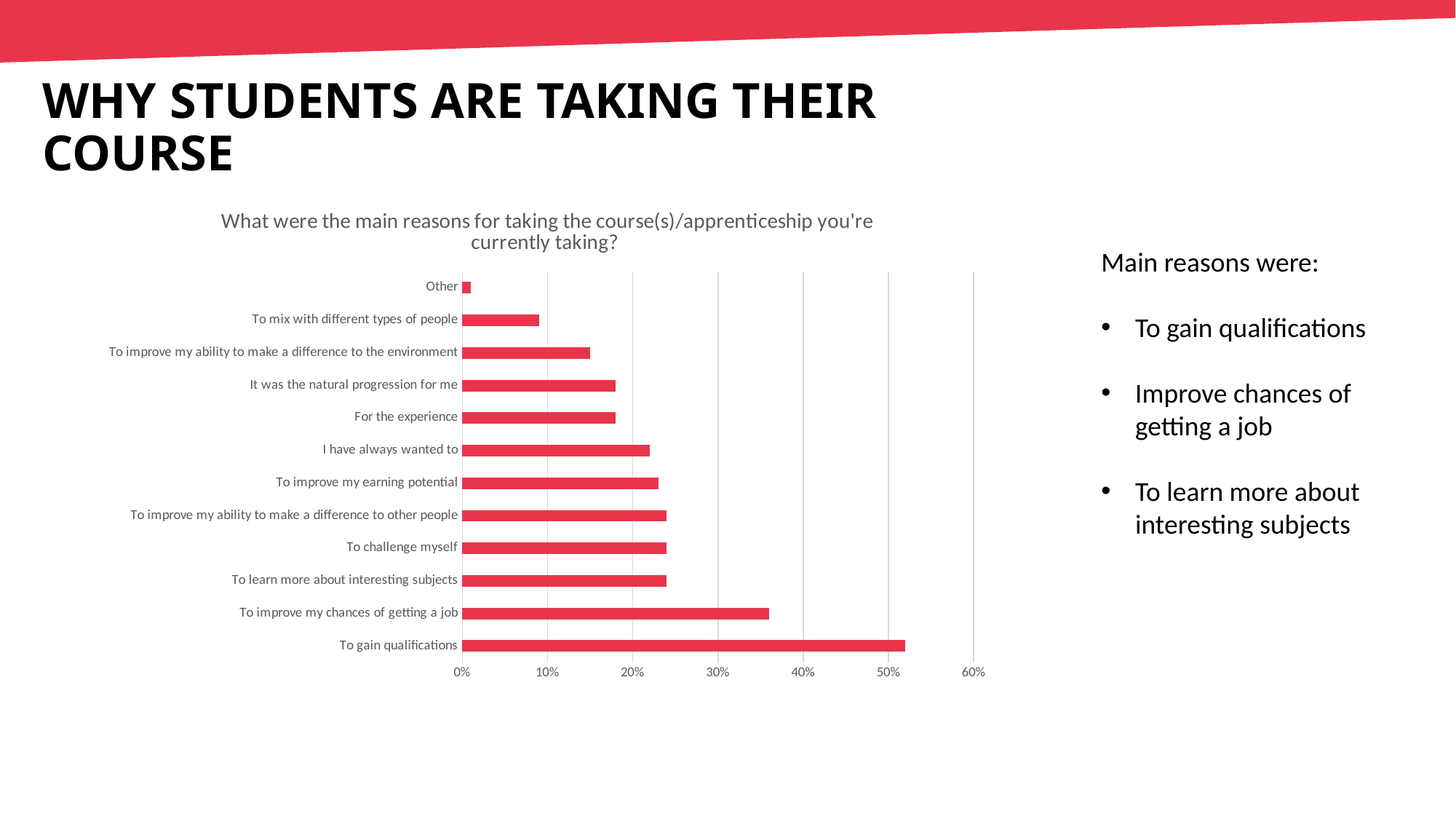
Is the value for "To improve my ability to make a difference to the environment" greater or less than 20%? less What is the title of the chart? What were the main reasons for taking the course(s)/apprenticeship you're currently taking? Is the value for "To improve my chances of getting a job" greater or less than 30%? greater Which reason has the highest value in the chart? To gain qualifications Which is larger: the value for "To improve my chances of getting a job" or the value for "To learn more about interesting subjects"? To improve my chances of getting a job What kind of chart is shown on the slide? Bar chart Which reason has the lowest value in the chart? Other How many categories (reasons) are plotted in the chart? 12 Is the value for "To gain qualifications" greater or less than 50%? greater Which is larger: the value for "It was the natural progression for me" or the value for "To mix with different types of people"? It was the natural progression for me